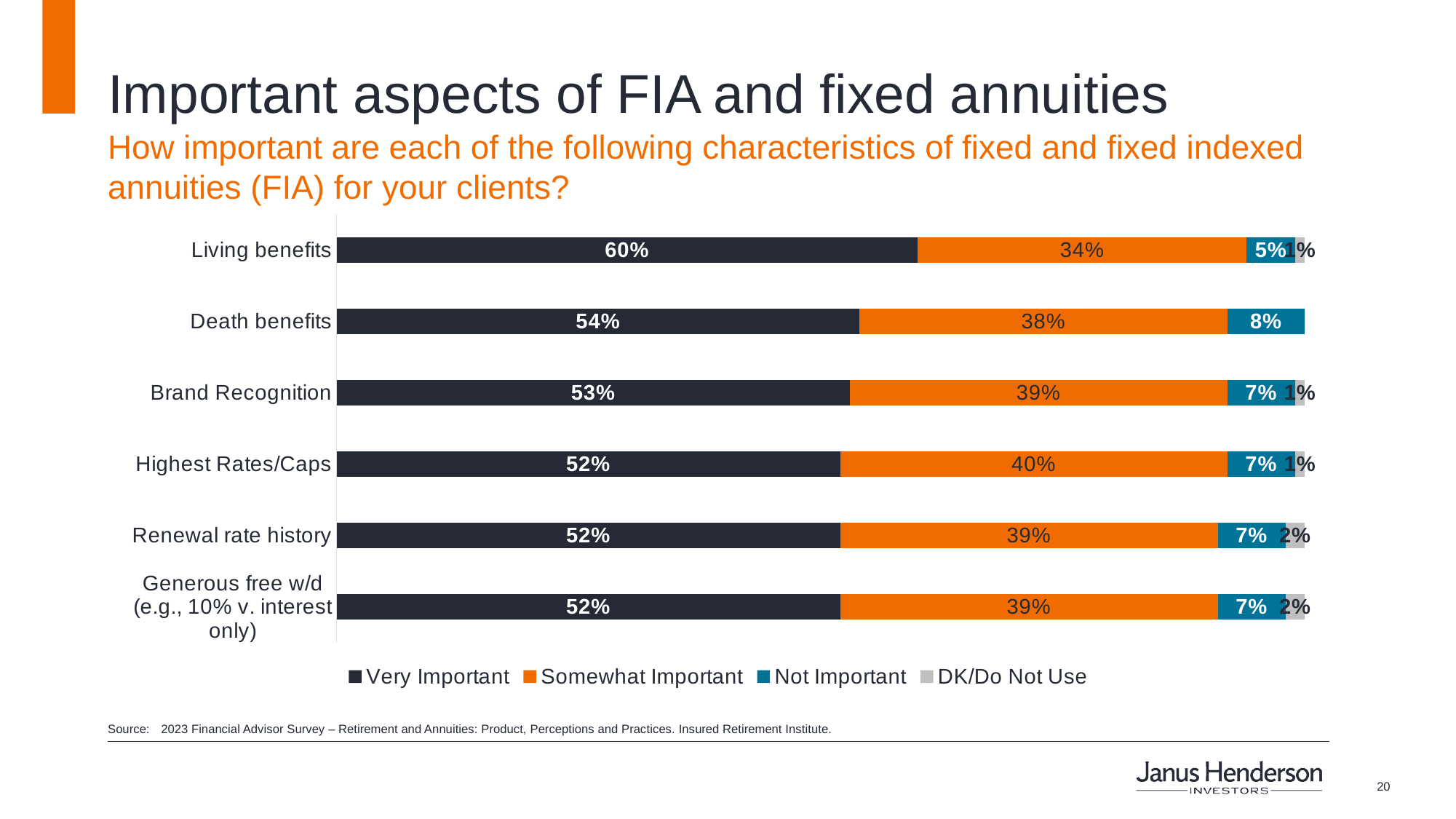
Which has a larger Not Important value, Death benefits or Living benefits? Death benefits Which characteristic has the highest Very Important percentage? Living benefits What kind of chart is shown on the slide? Stacked bar chart How many characteristics are shown on the chart? 6 What is the Somewhat Important value for Highest Rates/Caps? 40% What is the total of the Living benefits bar across all four segments? 100% Which characteristic has the lowest Somewhat Important percentage? Living benefits What is the Not Important value for Death benefits? 8% What is the DK/Do Not Use value for Renewal rate history? 2% What is the difference between the Very Important values for Living benefits and Death benefits? 6% What percentage of respondents rated Living benefits as Very Important? 60% How many series does the legend list? 4